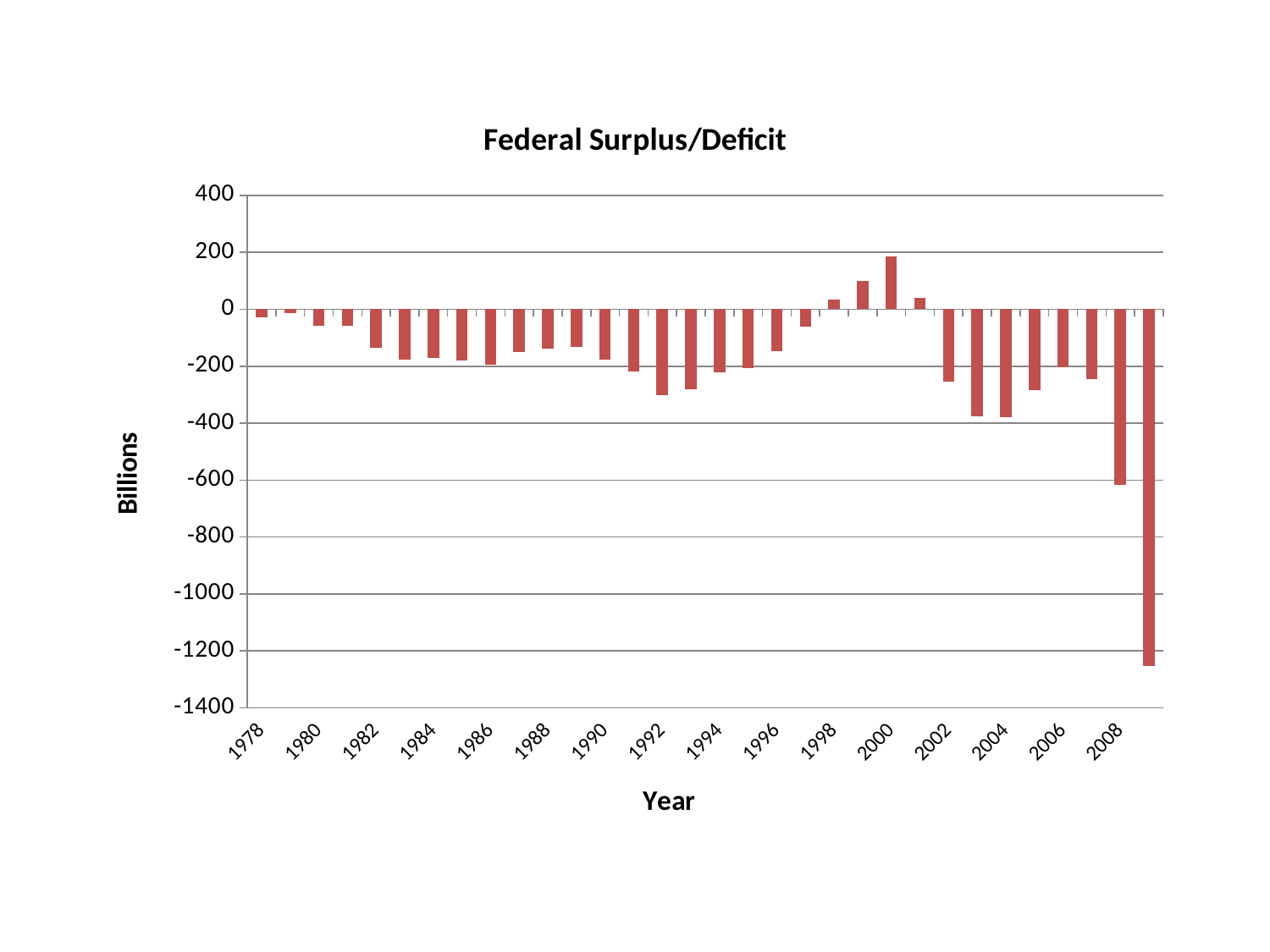
Which year has the highest value in the chart? 2000 Is the value for 1992 greater or less than -200? less Which is larger, the value for 1996 or the value for 2004? 1996 Is the value for 2008 greater or less than -400? less What is the label on the vertical axis of the chart? Billions What is the title of the chart? Federal Surplus/Deficit Which is larger, the value for 2000 or the value for 1998? 2000 Is the value for 1998 greater or less than 0? greater Do the values rise or fall from 1997 to 2000? rise What kind of chart is shown on the slide? bar chart